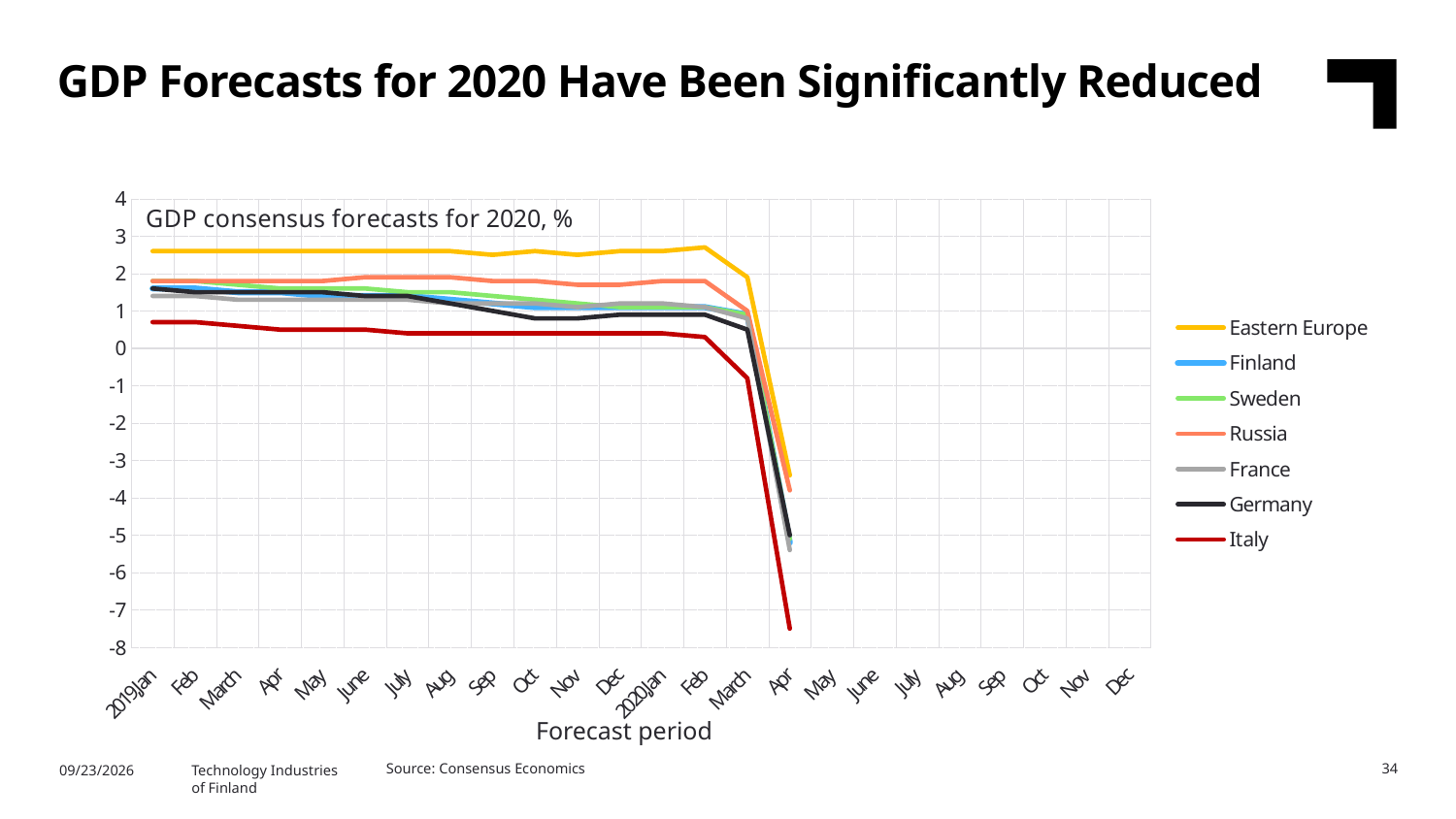
Is the value for Eastern Europe in 2019 Jan greater or less than 2? greater What is the x-axis title of the chart? Forecast period How many series does the legend list? 7 Is the value for Italy in 2020 Apr greater or less than -7? less How many forecast periods are labelled along the x axis? 24 Which series has the lowest GDP forecast in 2020 Apr? Italy What is the title shown inside the chart area? GDP consensus forecasts for 2020, % Which series has the highest GDP forecast in 2019 Jan? Eastern Europe Which is larger in 2019 Jan, the forecast for Eastern Europe or the forecast for Italy? Eastern Europe Which series has the lowest GDP forecast in 2019 Jan? Italy What kind of chart is shown on the slide? Line chart Do the GDP forecasts rise or fall between 2020 Feb and 2020 Apr? Fall